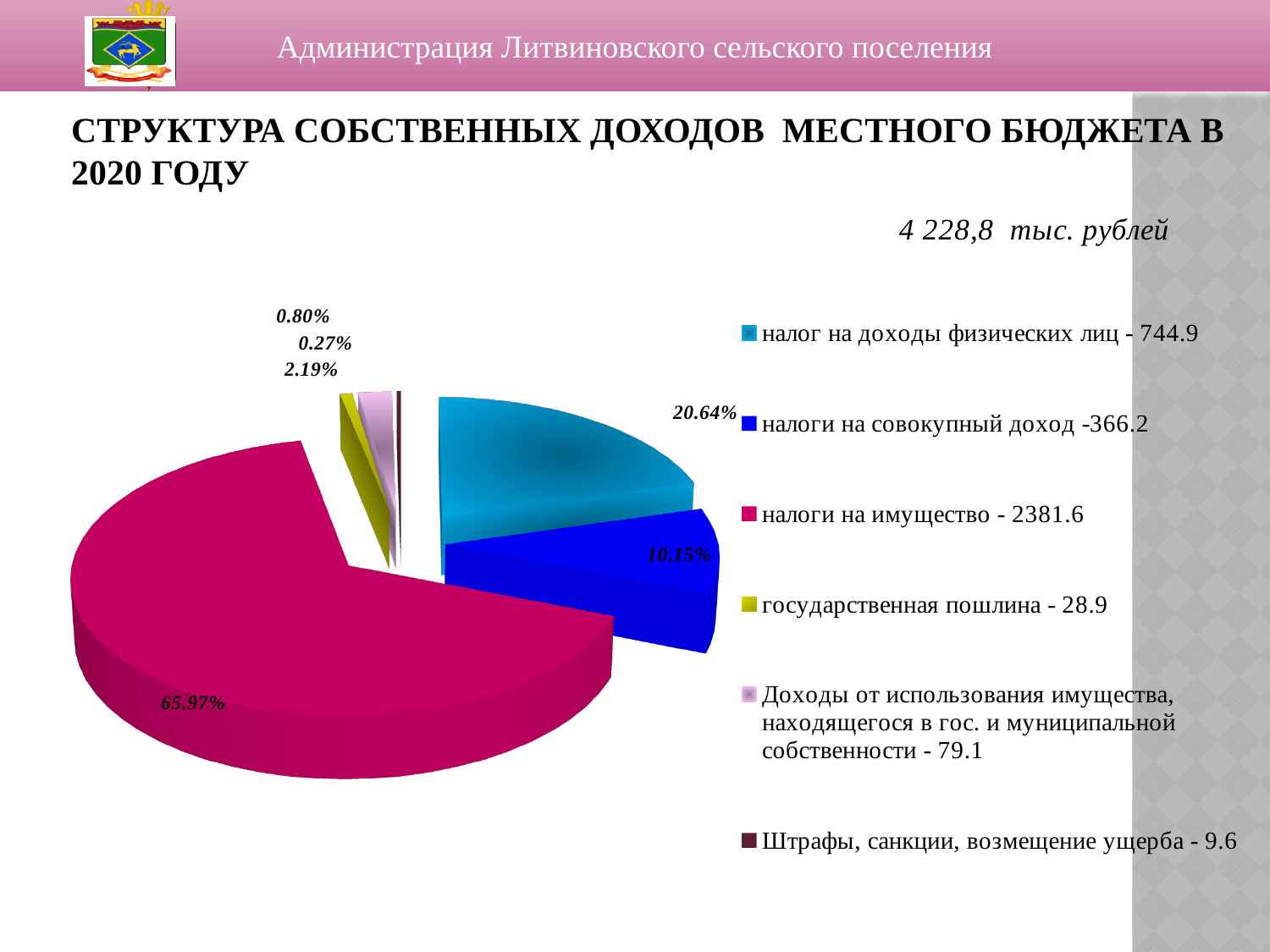
Which is larger: налог на доходы физических лиц or налоги на совокупный доход? налог на доходы физических лиц What share of the pie does налог на доходы физических лиц take? 20.64% What share of the pie does налоги на имущество take? 65.97% How many categories does the pie chart have? 6 What is the difference between the legend values for налог на доходы физических лиц and налоги на совокупный доход? 378.7 Which category has the smallest value in the legend? Штрафы, санкции, возмещение ущерба What total amount is stated above the chart? 4 228,8 тыс. рублей What value is given in the legend for государственная пошлина? 28.9 What share of the pie does налоги на совокупный доход take? 10.15% What kind of chart is shown on the slide? Pie chart What value is given in the legend for налоги на имущество? 2381.6 Which category has the largest slice of the pie? налоги на имущество